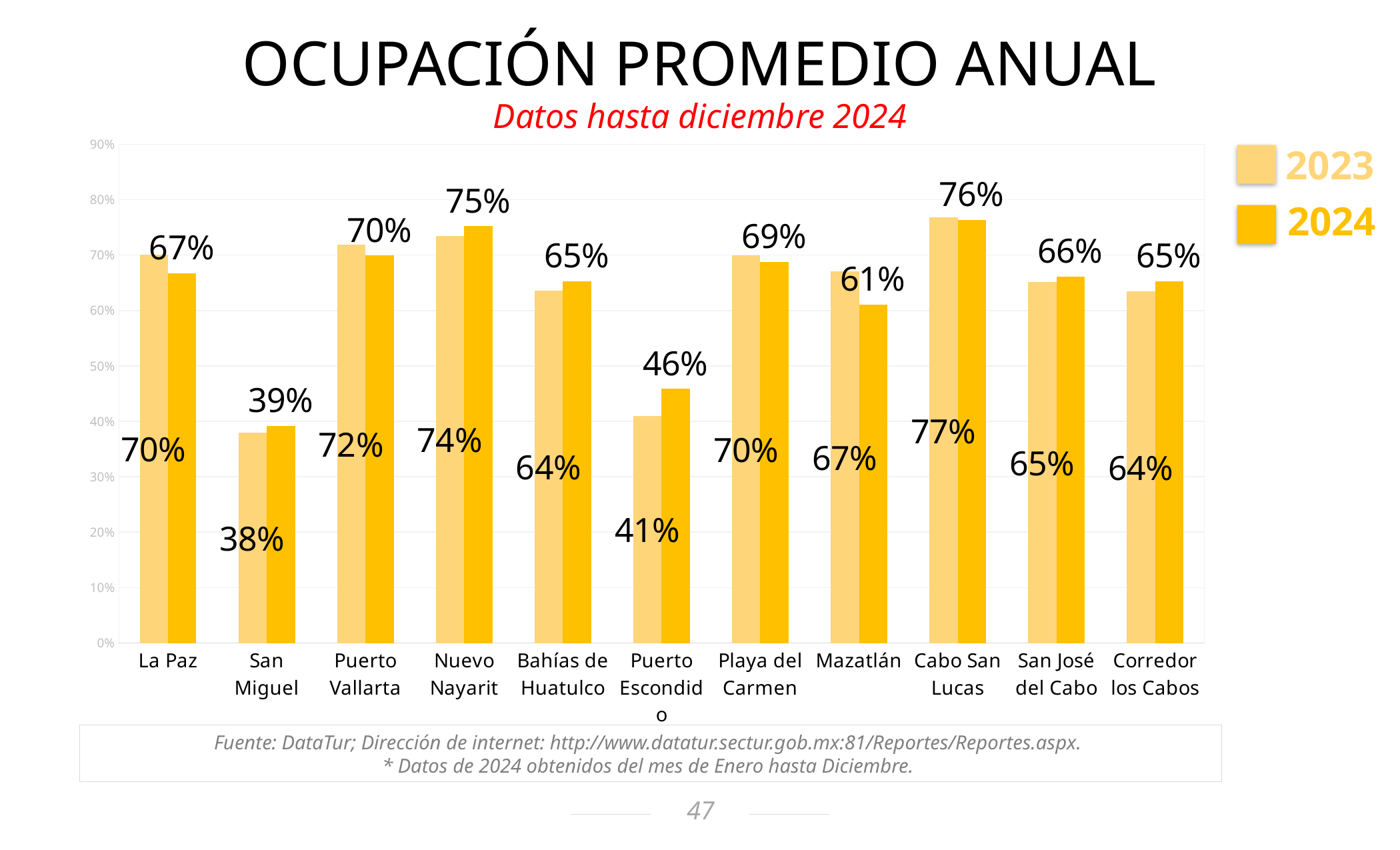
What is the 2024 value for Puerto Escondido? 46% Which is larger for Puerto Escondido, the 2023 value or the 2024 value? 2024 What is the 2023 value for San Miguel? 38% How many destinations are shown on the x axis? 11 Which destination has the highest 2024 value? Cabo San Lucas Is the 2024 value for Nuevo Nayarit greater or less than 70%? greater Which destination has the lowest 2023 value? San Miguel What kind of chart is shown on the slide? Bar chart What is the 2023 value for Cabo San Lucas? 77% What is the 2024 value for Mazatlán? 61% What is the difference between the 2023 and 2024 values for Mazatlán? 6% How many series does the legend list? 2